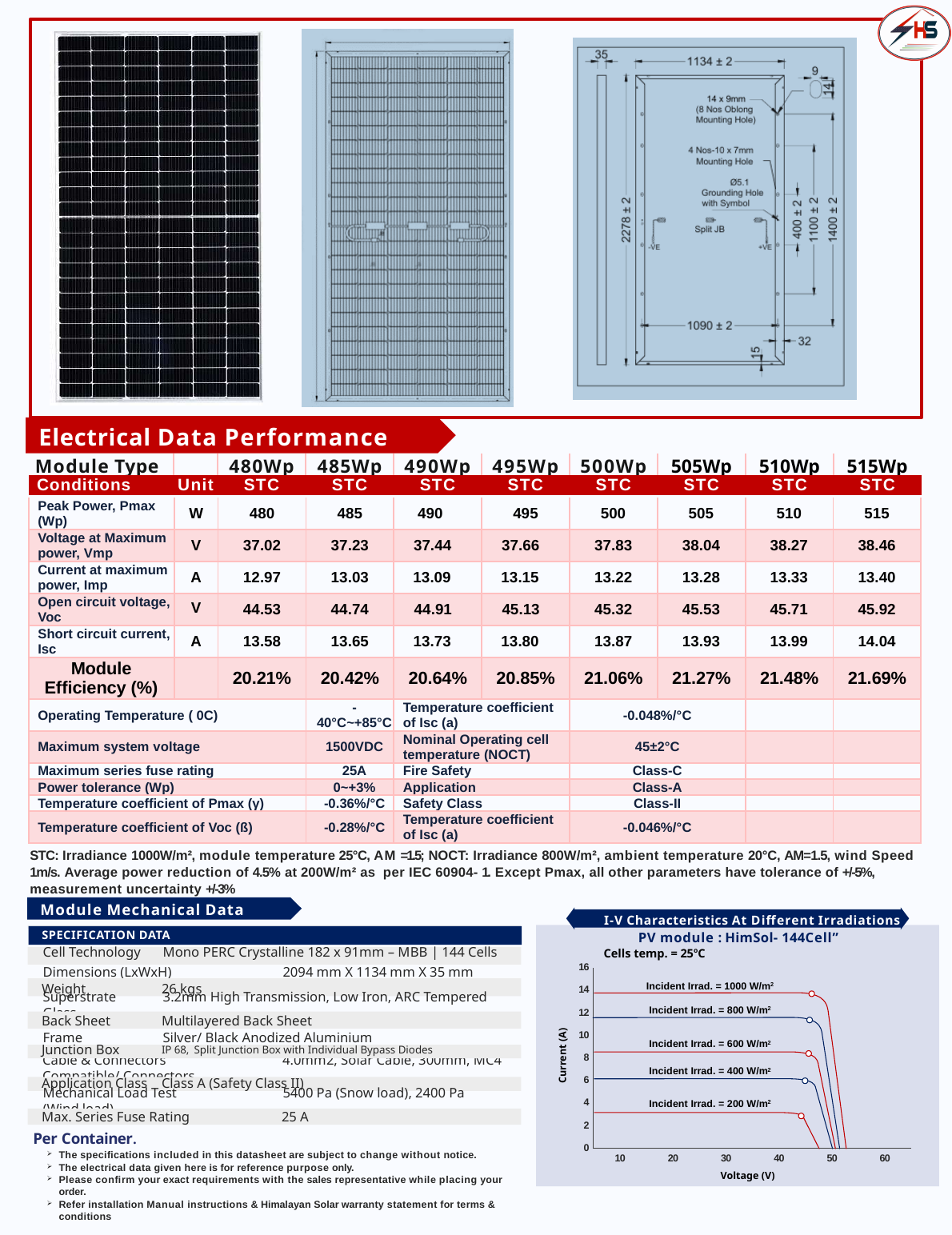
What cell temperature is stated on the I-V Characteristics chart? 25°C How many irradiance curves are plotted on the I-V Characteristics chart? 5 On the I-V Characteristics chart, is the current of the 600 W/m² curve at low voltage greater or less than 10 A? less On the I-V Characteristics chart, is the current of the 800 W/m² curve at low voltage greater or less than 10 A? greater On the I-V Characteristics chart, which curve carries more current: 800 W/m² or 600 W/m²? 800 W/m² On the I-V Characteristics chart, does the current rise or fall as voltage increases toward 50 V? fall What kind of chart is the I-V Characteristics chart? line chart Which incident irradiance curve has the lowest current on the I-V Characteristics chart? 200 W/m² Which incident irradiance curve reaches the highest current on the I-V Characteristics chart? 1000 W/m² On the I-V Characteristics chart, is the current of the 1000 W/m² curve at low voltage greater or less than 12 A? greater What is the label of the x axis on the I-V Characteristics chart? Voltage (V)